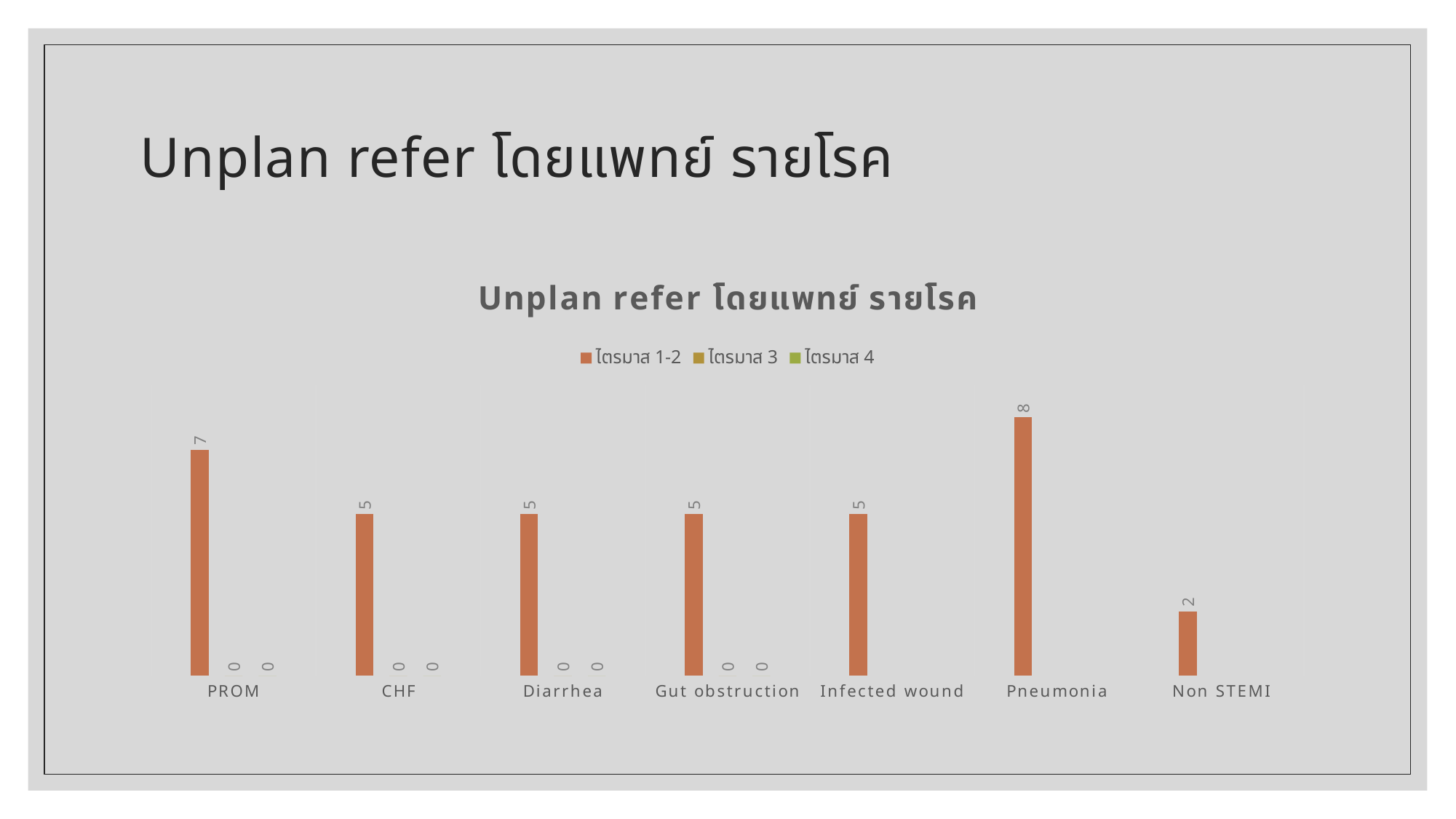
What type of chart is shown on the slide? Bar chart Which category has the lowest value in the ไตรมาส 1-2 series? Non STEMI What is the value for PROM in the ไตรมาส 1-2 series? 7 What is the title of the chart? Unplan refer โดยแพทย์ รายโรค Which is larger in the ไตรมาส 1-2 series, PROM or CHF? PROM How many series does the legend list? 3 What is the value for CHF in the ไตรมาส 3 series? 0 What is the value for Pneumonia in the ไตรมาส 1-2 series? 8 Which category has the highest value in the ไตรมาส 1-2 series? Pneumonia What is the value for Non STEMI in the ไตรมาส 1-2 series? 2 What is the difference between the ไตรมาส 1-2 values for Pneumonia and PROM? 1 How many categories are shown on the x axis? 7